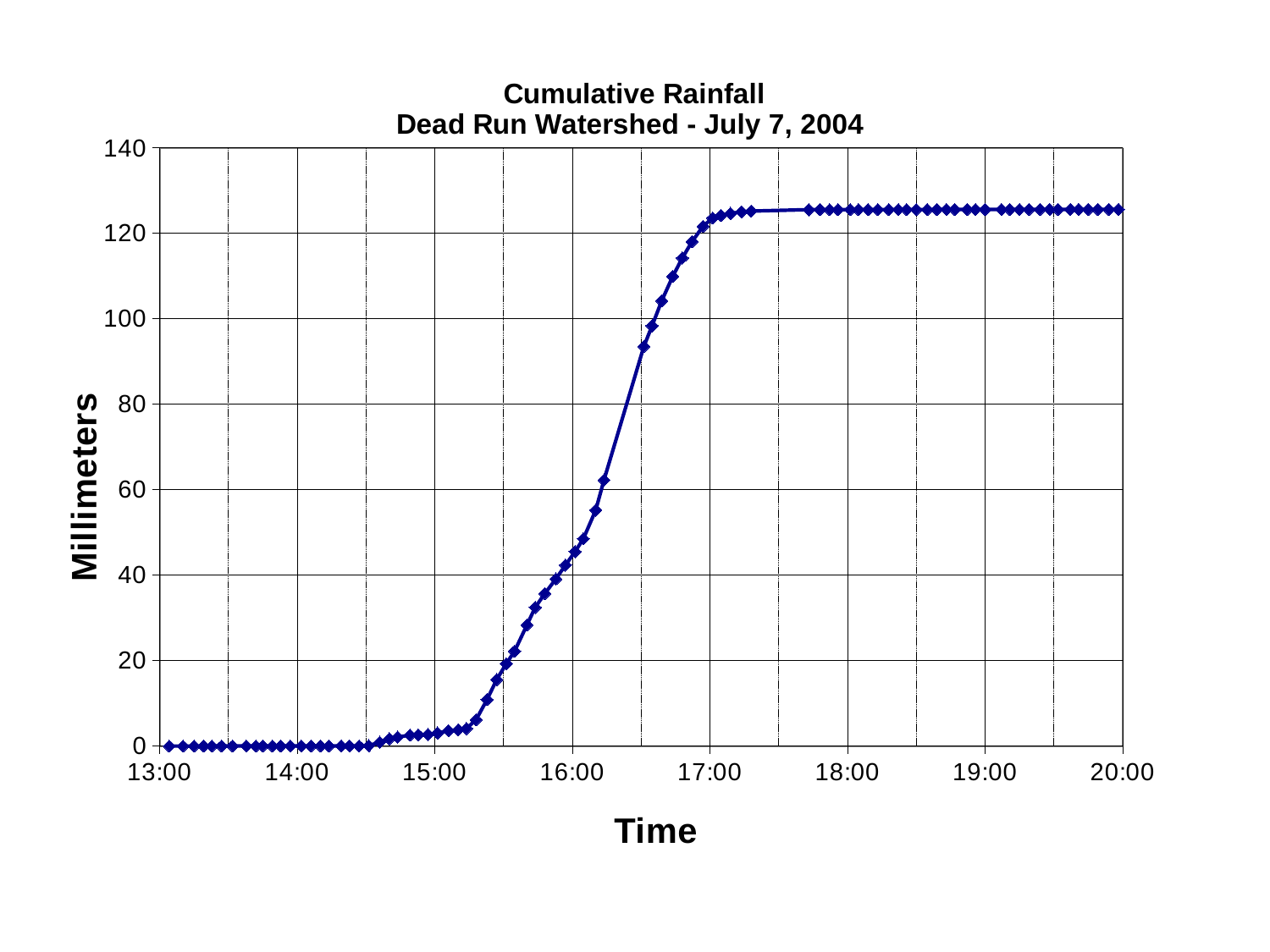
Do the plotted values rise or fall as time moves from 13:00 to 20:00? rise Is the value at 19:00 greater or less than 120? greater Which time has the larger cumulative rainfall value, 15:00 or 17:00? 17:00 Is the value at 18:00 greater or less than 140? less What is the cumulative rainfall value at 14:00? 0 What is the label on the vertical axis of the chart? Millimeters Is the value at 15:00 greater or less than 20? less Which time has the larger cumulative rainfall value, 16:00 or 16:30? 16:30 What kind of chart is shown on the slide? line chart What is the title of the chart? Cumulative Rainfall Dead Run Watershed - July 7, 2004